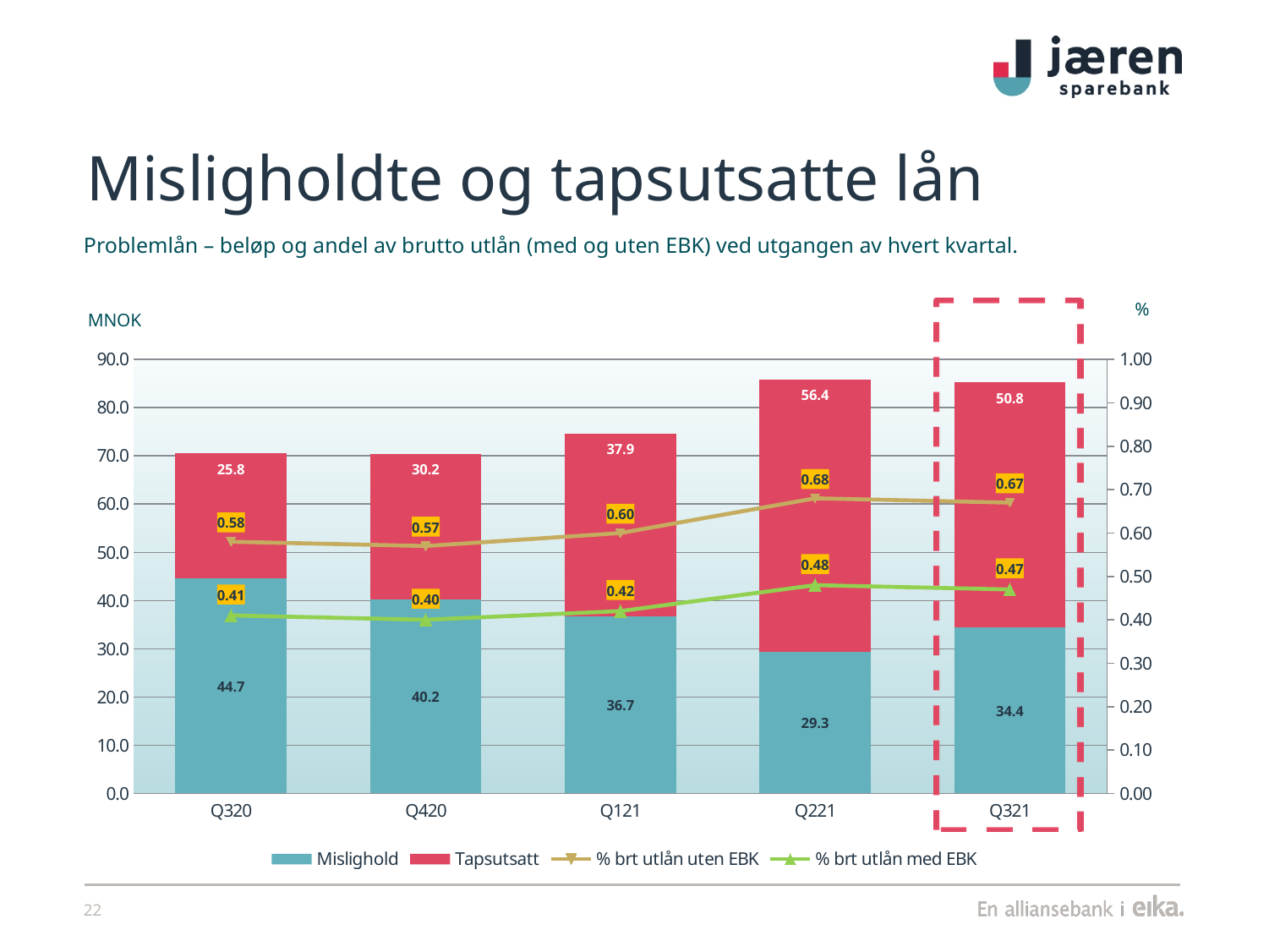
In which quarter is the Mislighold value highest? Q320 How many quarters are shown on the x axis? 5 Does the % brt utlån uten EBK line rise or fall from Q420 to Q221? rise What is the value of % brt utlån uten EBK for Q121? 0.60 Which is larger for Q121: Mislighold or Tapsutsatt? Tapsutsatt In which quarter is the Tapsutsatt value lowest? Q320 What is the Tapsutsatt value for Q221? 56.4 What is the Mislighold value for Q321? 34.4 What is the value of % brt utlån med EBK for Q420? 0.40 What is the difference between the Tapsutsatt values for Q221 and Q321? 5.6 What is the total of the stacked bar for Q221 (Mislighold plus Tapsutsatt)? 85.7 How many series does the legend list? 4